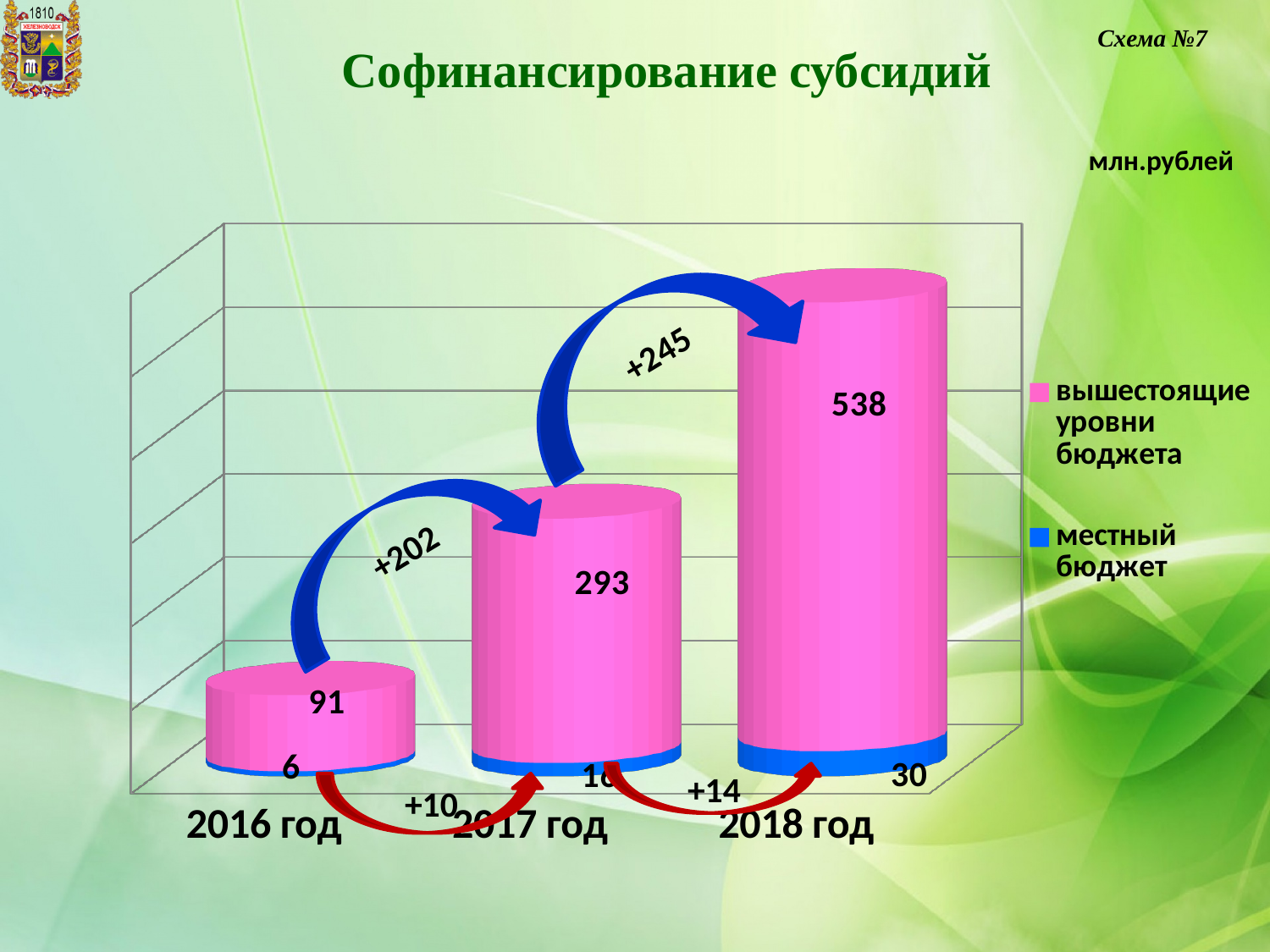
How many years are shown on the x axis? 3 What is the difference between the вышестоящие уровни бюджета values for 2018 год and 2017 год? 245 What is the value for вышестоящие уровни бюджета in 2017 год? 293 What is the value for вышестоящие уровни бюджета in 2016 год? 91 Which year has the highest value for вышестоящие уровни бюджета? 2018 год What is the value for вышестоящие уровни бюджета in 2018 год? 538 What is the total of the stacked bar for 2018 год? 568 What is the value for местный бюджет in 2016 год? 6 How many series does the legend list? 2 Which year has the lowest value for местный бюджет? 2016 год What is the value for местный бюджет in 2018 год? 30 Do the values for вышестоящие уровни бюджета rise or fall from 2016 год to 2018 год? rise